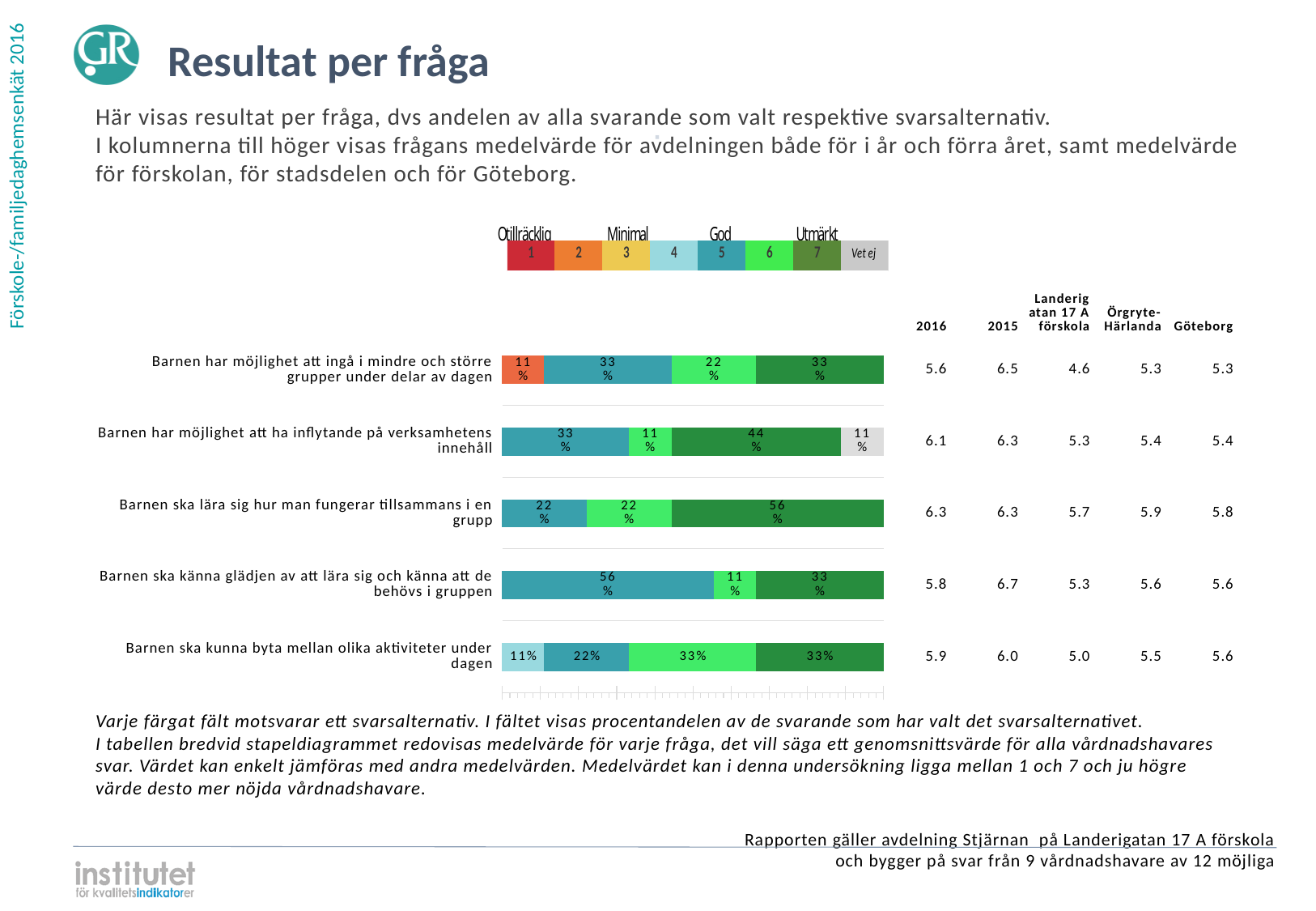
What is the 2016 mean value shown for "Barnen ska lära sig hur man fungerar tillsammans i en grupp"? 6.3 What percentage of respondents chose 5 for "Barnen ska känna glädjen av att lära sig och känna att de behövs i gruppen"? 56% What percentage of respondents answered "Vet ej" for "Barnen har möjlighet att ha inflytande på verksamhetens innehåll"? 11% Which question has the largest share of respondents choosing 7 (Utmärkt)? Barnen ska lära sig hur man fungerar tillsammans i en grupp What kind of chart is shown on the slide? Stacked bar chart How many answer alternatives does the legend above the chart list? 8 How many questions (categories) are plotted in the bar chart? 5 What is the difference between the share choosing 7 and the share choosing 6 for "Barnen har möjlighet att ha inflytande på verksamhetens innehåll"? 33% For "Barnen ska kunna byta mellan olika aktiviteter under dagen", which is larger: the share choosing 5 or the share choosing 6? 6 What percentage of respondents chose 7 (Utmärkt) for "Barnen ska lära sig hur man fungerar tillsammans i en grupp"? 56% What percentage of respondents chose 4 for "Barnen ska kunna byta mellan olika aktiviteter under dagen"? 11% What is the combined share of respondents choosing 6 or 7 for "Barnen har möjlighet att ingå i mindre och större grupper under delar av dagen"? 55%